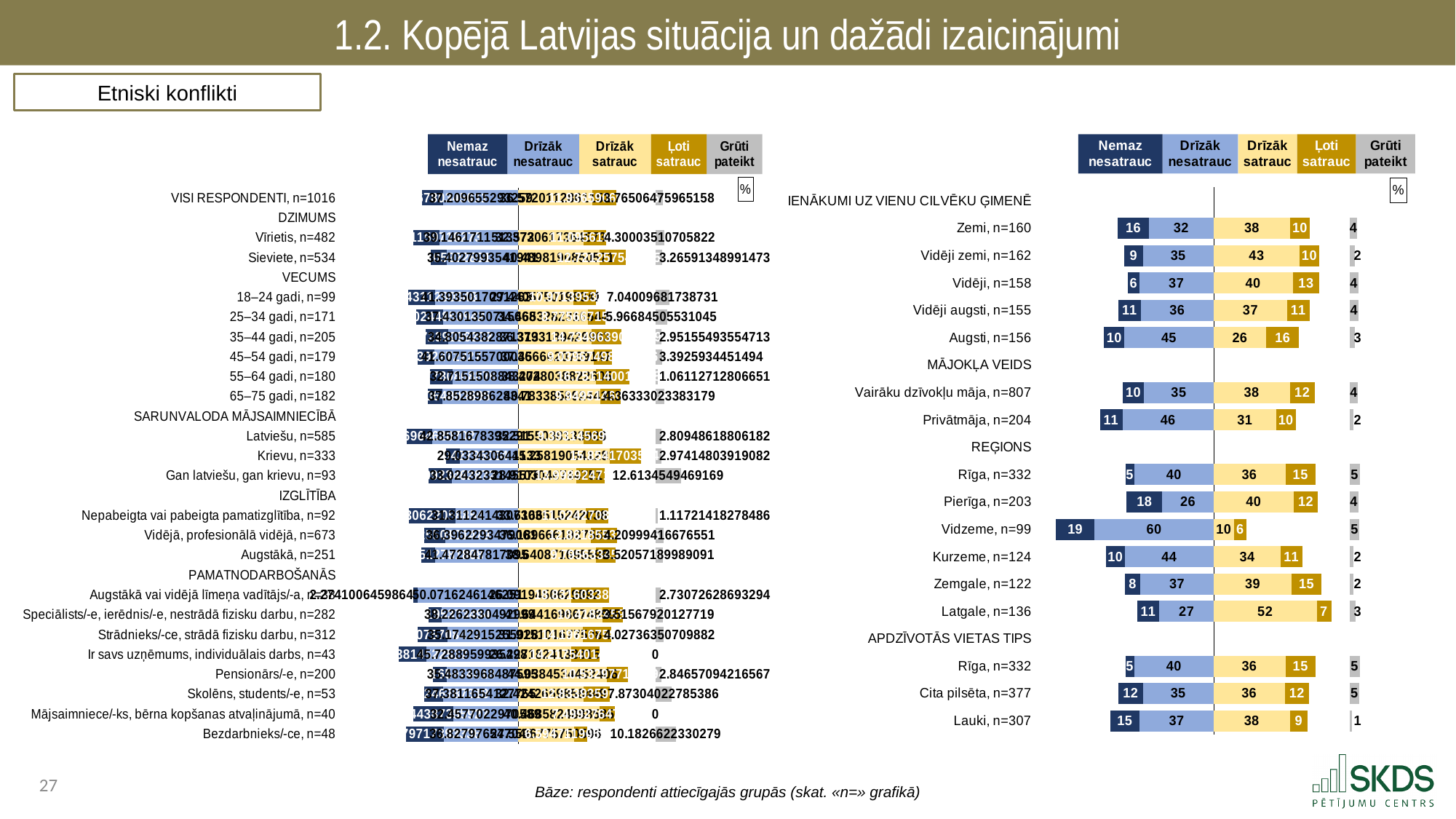
On the right-hand chart, what is the 'Drīzāk nesatrauc' value for Vidzeme, n=99? 60 On the right-hand chart, what is the 'Grūti pateikt' value for Lauki, n=307? 1 On the right-hand chart, what is the difference between the 'Drīzāk nesatrauc' values for Privātmāja, n=204 and Vairāku dzīvokļu māja, n=807? 11 How many series does the legend of the right-hand chart list? 5 On the right-hand chart, which is larger: the 'Drīzāk satrauc' value for Vidēji zemi, n=162 or for Zemi, n=160? Vidēji zemi, n=162 On the right-hand chart, what is the total of the 'Drīzāk satrauc' and 'Ļoti satrauc' values for Rīga, n=332? 51 What kind of chart is the right-hand chart? Stacked bar chart On the right-hand chart, what is the 'Ļoti satrauc' value for Augsti, n=156? 16 On the right-hand chart, what is the 'Nemaz nesatrauc' value for Pierīga, n=203? 18 On the right-hand chart, which region has the highest 'Drīzāk satrauc' value? Latgale, n=136 On the right-hand chart, what is the 'Drīzāk satrauc' value for Latgale, n=136? 52 On the right-hand chart, which region has the lowest 'Ļoti satrauc' value? Vidzeme, n=99